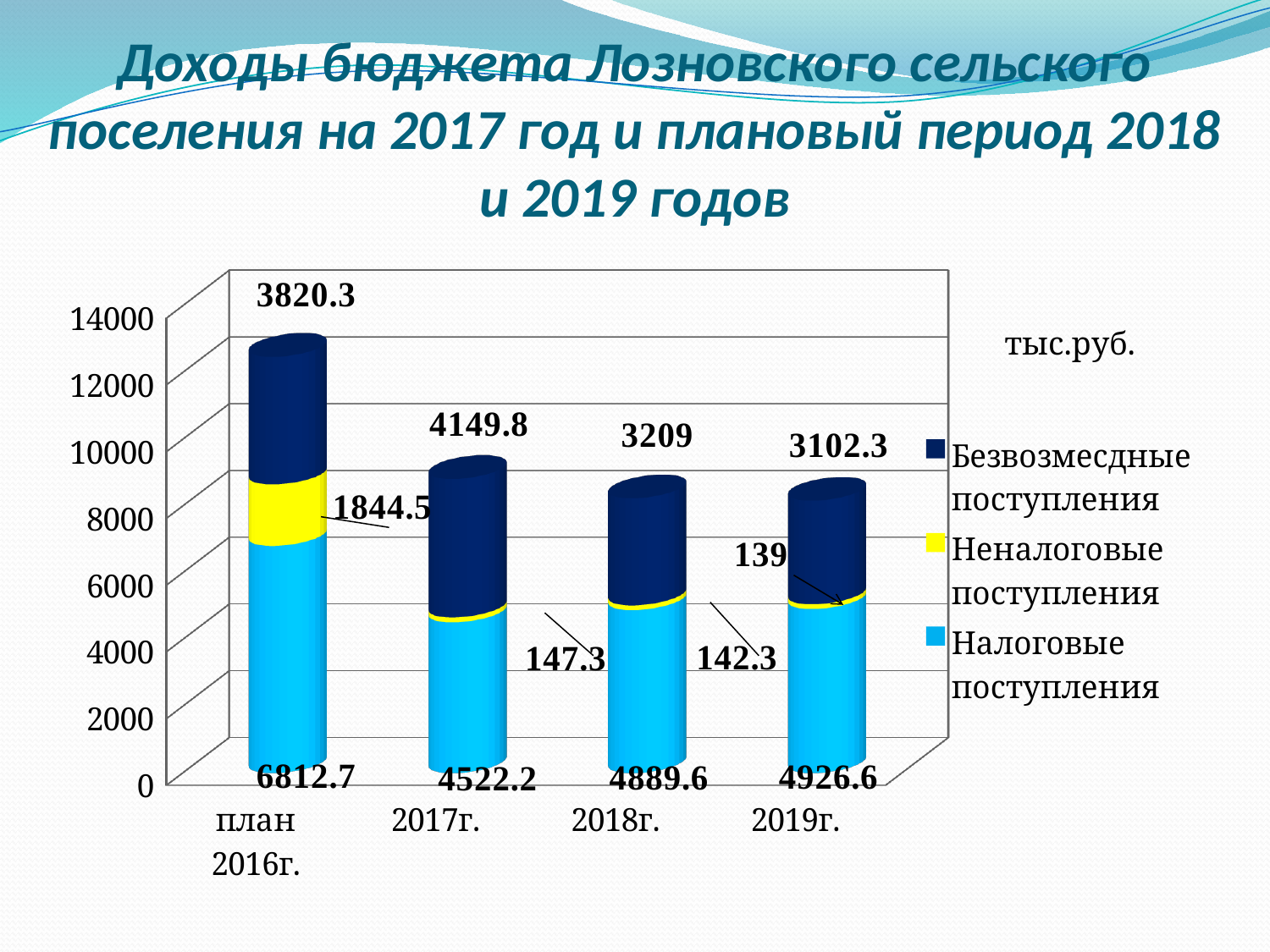
How many series does the legend list? 3 Which category has the lowest value of Безвозмездные поступления? 2019г. What is the value of Безвозмездные поступления for 2017г.? 4149.8 Which is larger: Безвозмездные поступления for 2018г. or for 2019г.? 2018г. What is the total of the stacked bar for 2017г.? 8819.3 What type of chart is shown on the slide? bar chart Which category has the highest value of Неналоговые поступления? план 2016г. What is the value of Неналоговые поступления for 2019г.? 139 How many categories are shown on the x axis? 4 What is the difference between Налоговые поступления for 2019г. and 2017г.? 404.4 What unit is indicated next to the chart? тыс.руб. What is the value of Налоговые поступления for план 2016г.? 6812.7